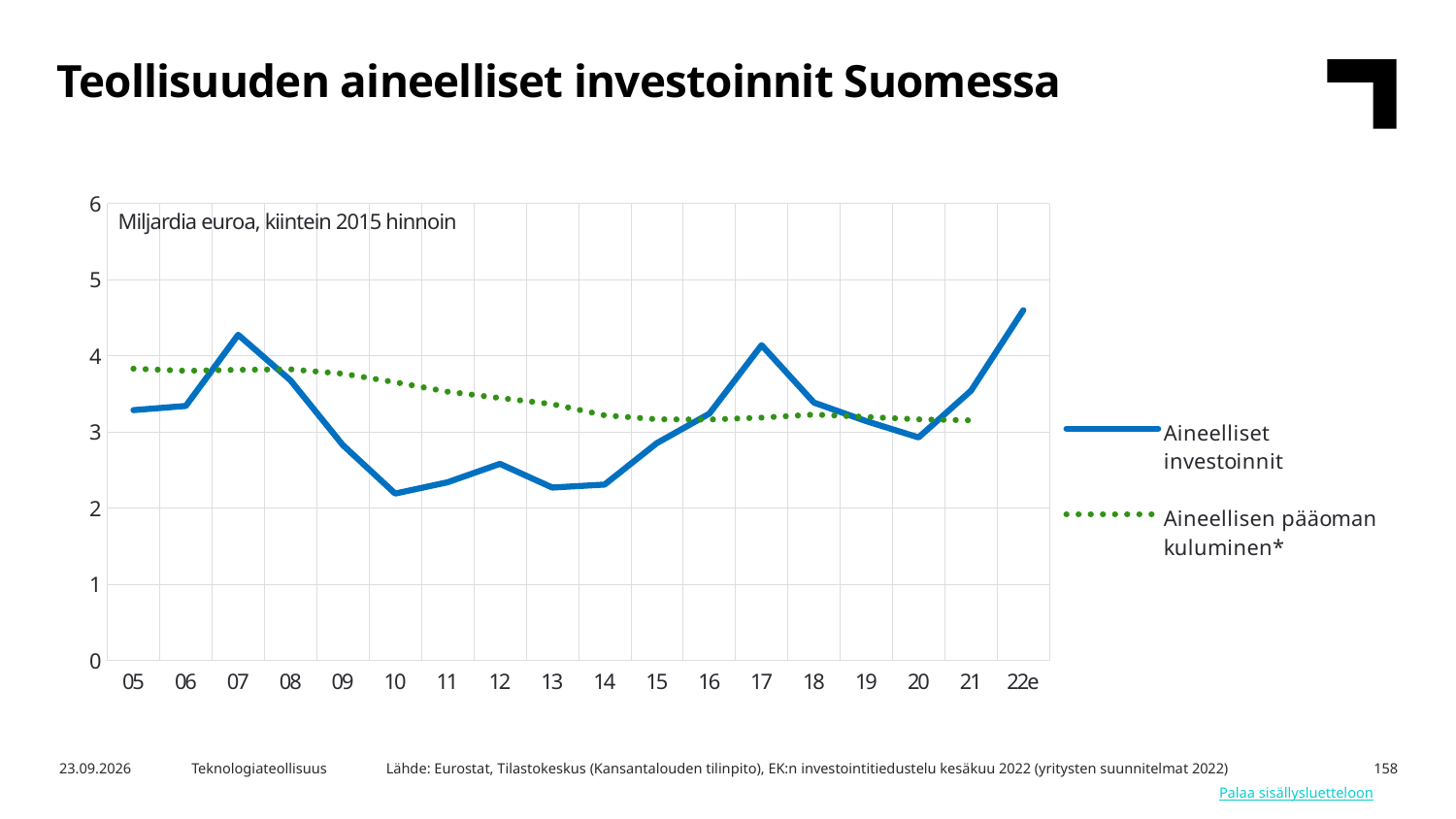
Does the Aineellisen pääoman kuluminen* series generally rise or fall from 05 to 21? Fall What unit is stated in the label inside the chart area? Miljardia euroa, kiintein 2015 hinnoin Is the value of Aineelliset investoinnit in 10 greater or less than 3? less Is the value of Aineellisen pääoman kuluminen* in 10 greater or less than 3? greater Is the value of Aineelliset investoinnit in 07 greater or less than 4? greater Which is larger in 17: Aineelliset investoinnit or Aineellisen pääoman kuluminen*? Aineelliset investoinnit How many years are shown on the x axis? 18 Which is larger in 10: Aineelliset investoinnit or Aineellisen pääoman kuluminen*? Aineellisen pääoman kuluminen* How many series does the legend list? 2 What kind of chart is shown on the slide? Line chart In which year does the Aineelliset investoinnit series reach its highest value? 22e